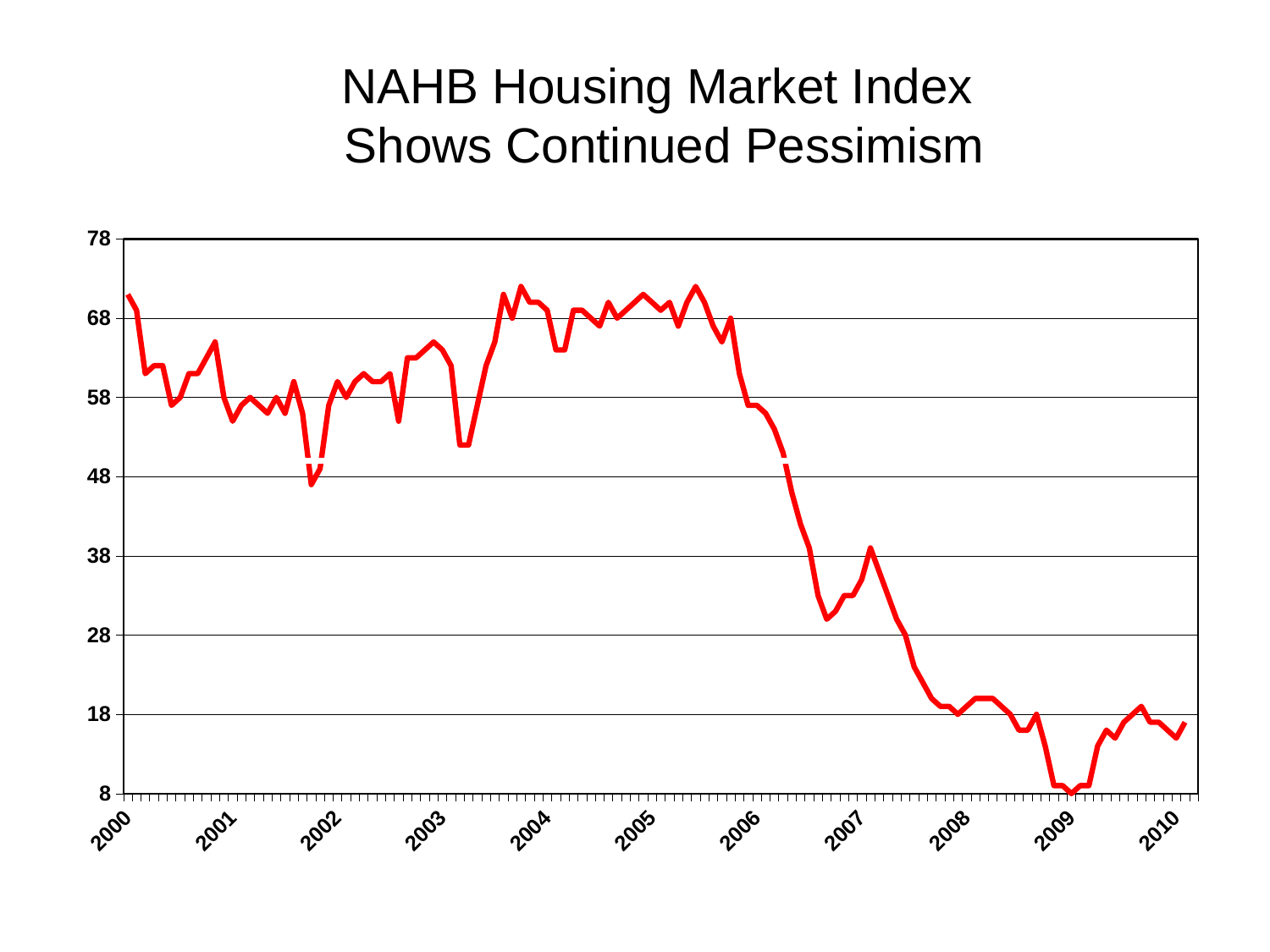
What colour is the plotted line? red Is the value at the start of 2000 greater or less than 68? greater Is the value at the start of 2010 greater or less than 18? less Is the value at the start of 2005 greater or less than 68? greater What is the title of the chart? NAHB Housing Market Index Shows Continued Pessimism Overall, does the index rise or fall between 2000 and 2010? fall What kind of chart is shown on the slide? line chart In which year does the line reach its lowest point? 2009 How many year labels are shown on the x axis? 11 Does the index rise or fall between the start of 2006 and the start of 2009? fall